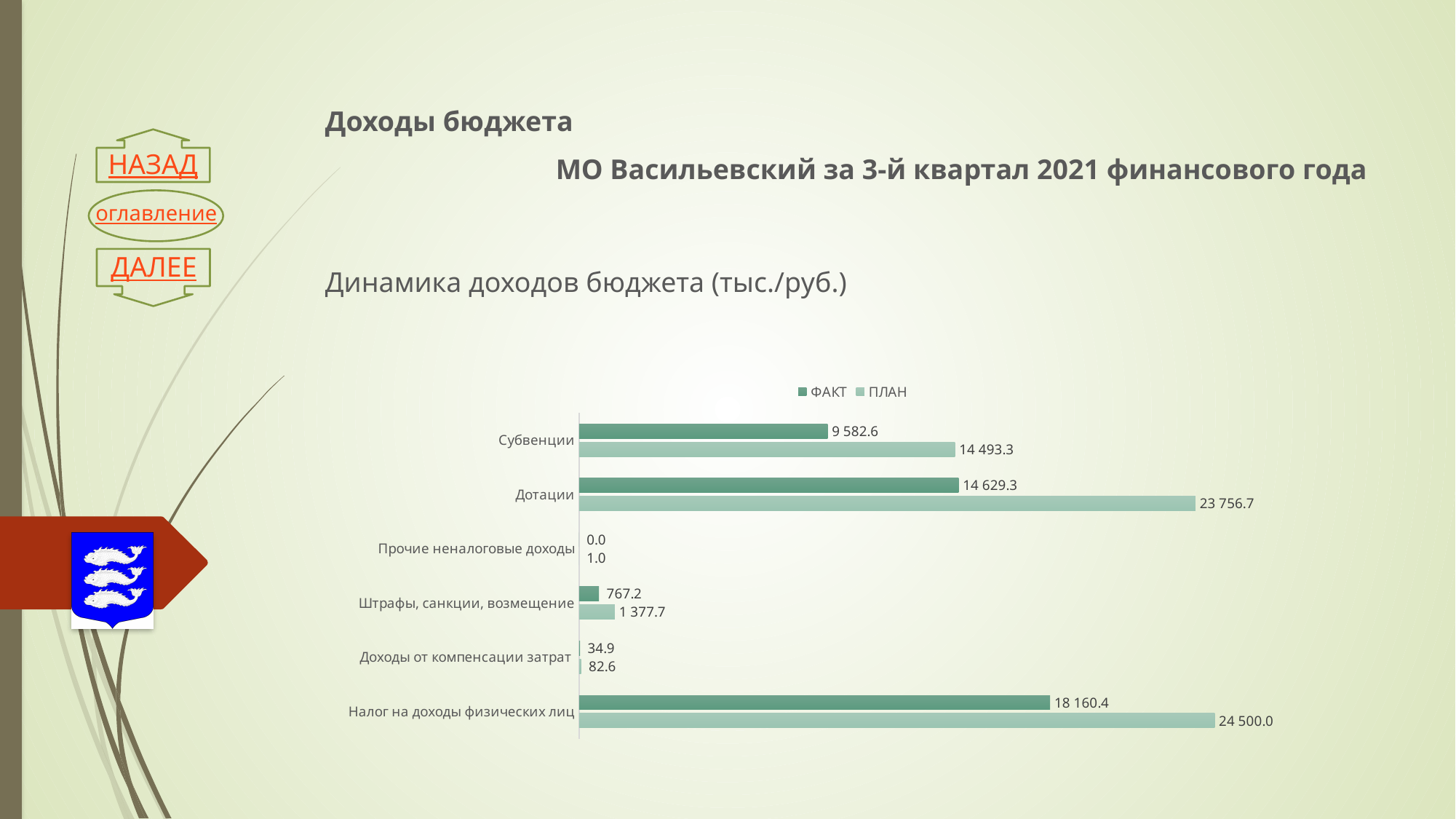
What is the ПЛАН value for Дотации? 23 756.7 What is the ПЛАН value for Налог на доходы физических лиц? 24 500.0 Which category has the lowest ПЛАН value? Прочие неналоговые доходы Which category has the highest ФАКТ value? Налог на доходы физических лиц What is the ФАКТ value for Доходы от компенсации затрат? 34.9 What are the two series named in the legend? ФАКТ and ПЛАН Which is larger: the ФАКТ value for Дотации or the ФАКТ value for Субвенции? Дотации How many series does the legend list? 2 What is the ФАКТ value for Субвенции? 9 582.6 What is the difference between the ПЛАН and ФАКТ values for Субвенции? 4 910.7 How many categories are shown on the chart? 6 What type of chart is shown on the slide? bar chart